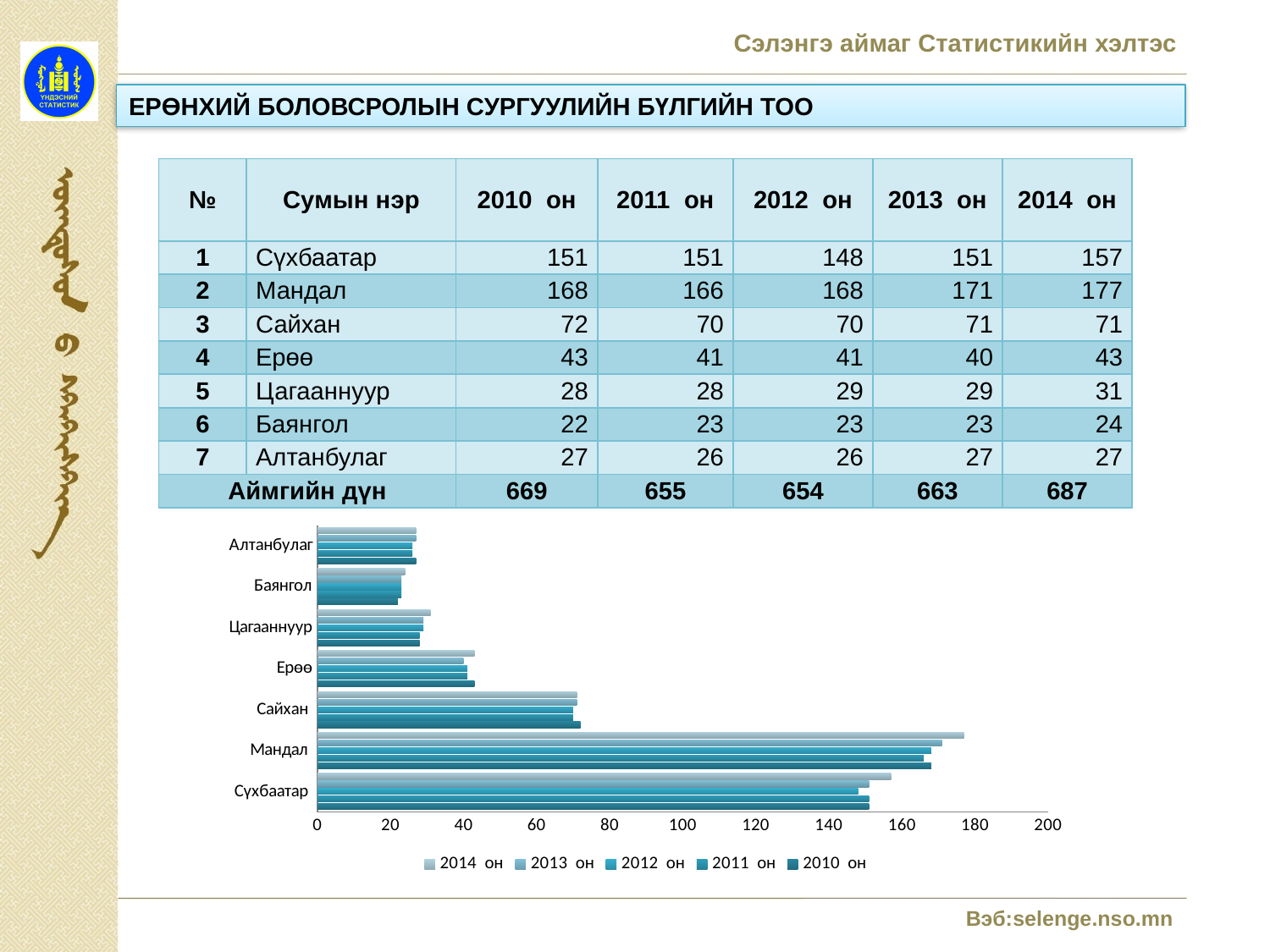
Which sum has the lowest value for 2014 он? Баянгол How many sums (categories) are plotted on the chart's vertical axis? 7 What is the highest tick value shown on the chart's horizontal axis? 200 What is the value for Цагааннуур in 2014 он? 31 What is the value for Ерөө in 2013 он? 40 How many series does the chart's legend list? 5 Is the value for Сайхан in 2010 он greater or less than 80? less What is the difference between the 2014 он values for Мандал and Сүхбаатар? 20 Is the value for Мандал in 2014 он greater or less than 160? greater Which is larger in 2012 он, the value for Сүхбаатар or the value for Мандал? Мандал What kind of chart is shown below the table on the slide? bar chart Which sum has the highest value for 2014 он? Мандал